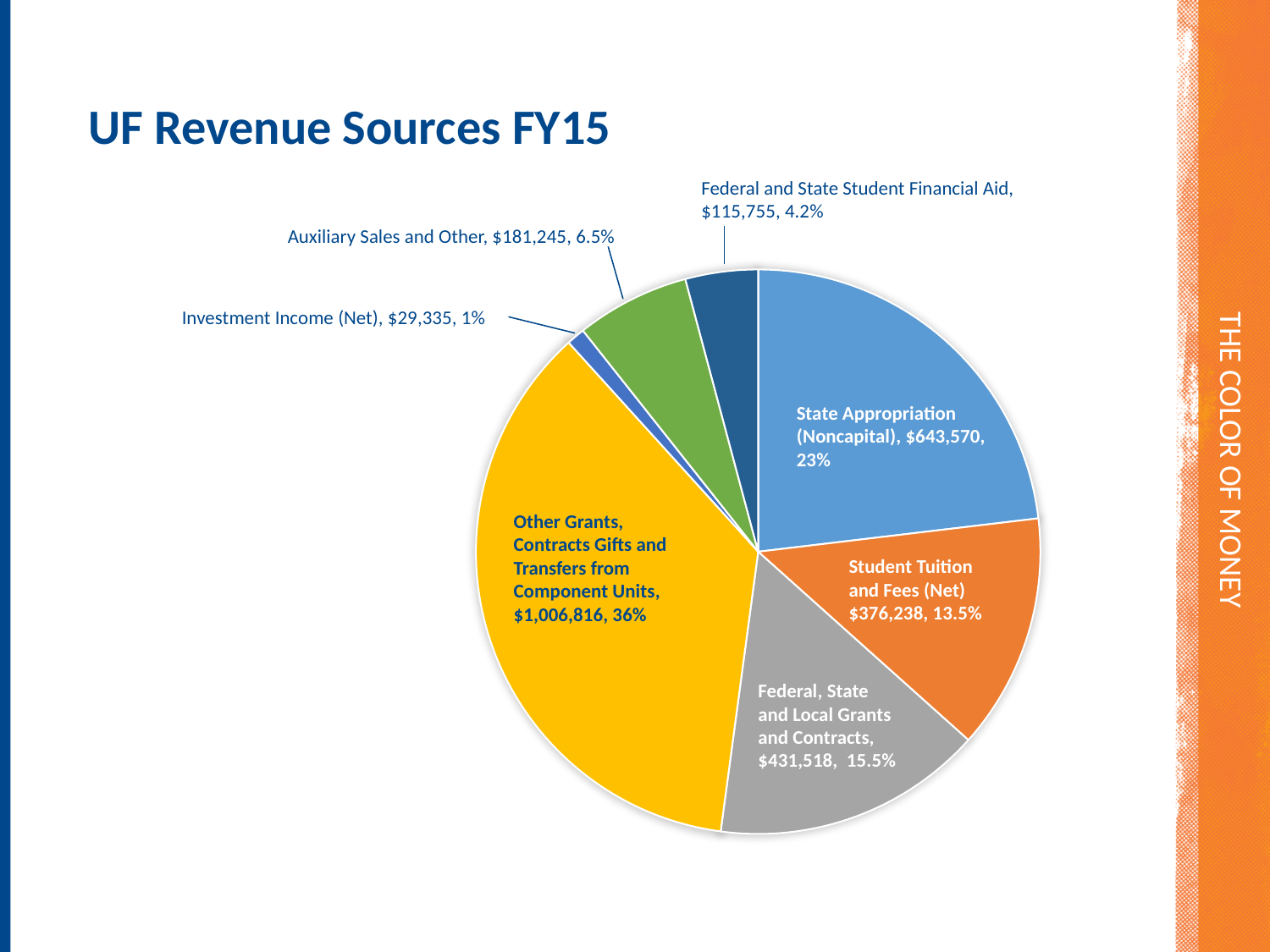
What is the title of the chart? UF Revenue Sources FY15 What is the value for State Appropriation (Noncapital)? $643,570 What is the value for Investment Income (Net)? $29,335 What kind of chart is shown on the slide? Pie chart What share of the pie does Auxiliary Sales and Other represent? 6.5% Which revenue source is the largest? Other Grants, Contracts Gifts and Transfers from Component Units What is the difference between the values for State Appropriation (Noncapital) and Student Tuition and Fees (Net)? $267,332 What share of the pie does Federal, State and Local Grants and Contracts represent? 15.5% How many slices does the pie chart have? 7 Which is larger, Federal and State Student Financial Aid or Auxiliary Sales and Other? Auxiliary Sales and Other What is the value for Student Tuition and Fees (Net)? $376,238 Which revenue source is the smallest? Investment Income (Net)